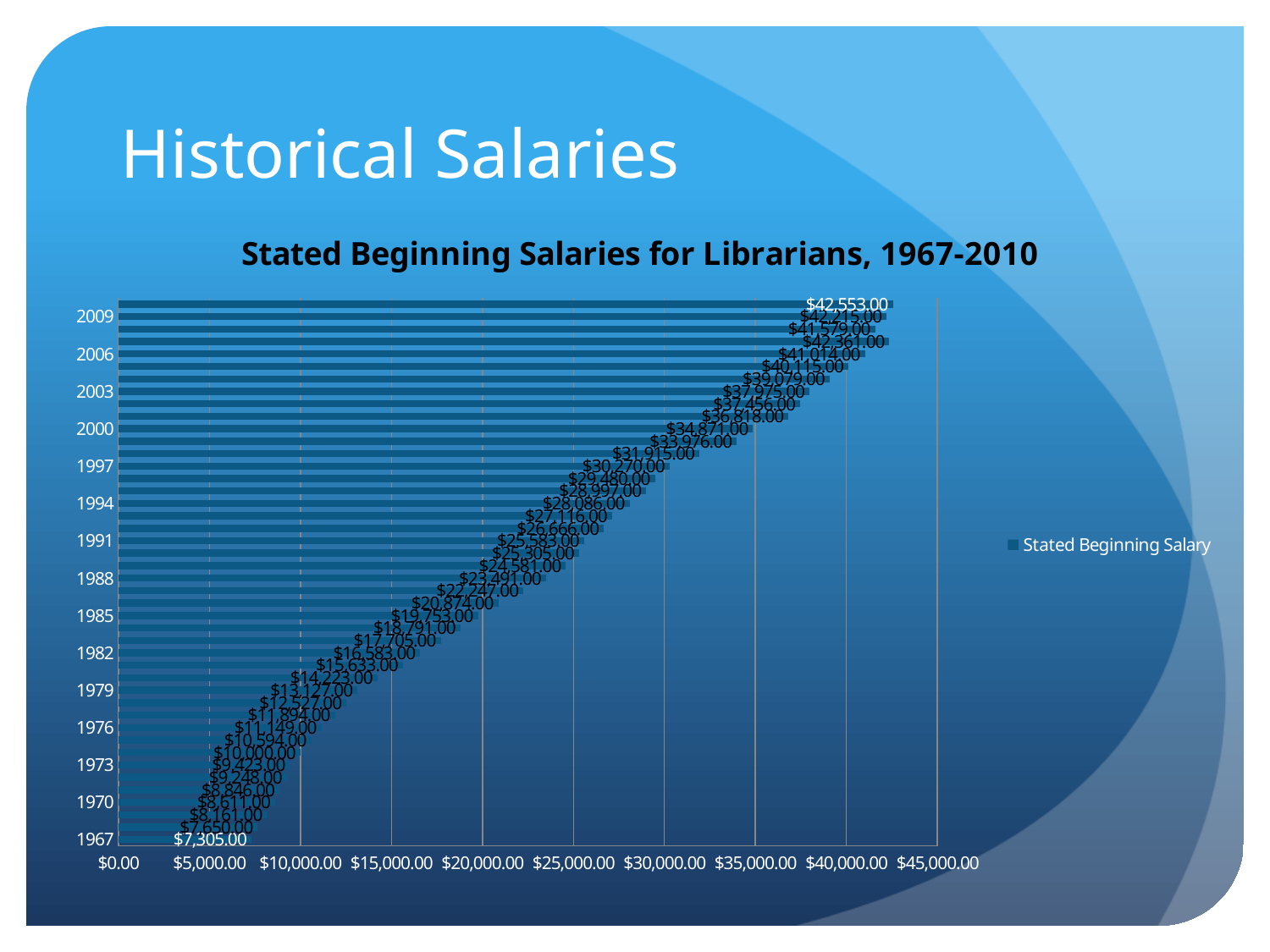
What is the difference between the stated beginning salary for 2010 and for 1967? $35,248.00 Which year has the larger stated beginning salary, 1985 or 2000? 2000 How many series does the legend list? 1 What is the stated beginning salary for 1967? $7,305.00 What is the title of the chart? Stated Beginning Salaries for Librarians, 1967-2010 Is the stated beginning salary for 1970 greater or less than $10,000.00? less Is the stated beginning salary for 2009 greater or less than $40,000.00? greater What kind of chart is shown on the slide? Bar chart What is the name of the series shown in the legend? Stated Beginning Salary Which year has the lowest stated beginning salary? 1967 Which year has the highest stated beginning salary? 2010 What is the stated beginning salary for 2010, the top bar? $42,553.00